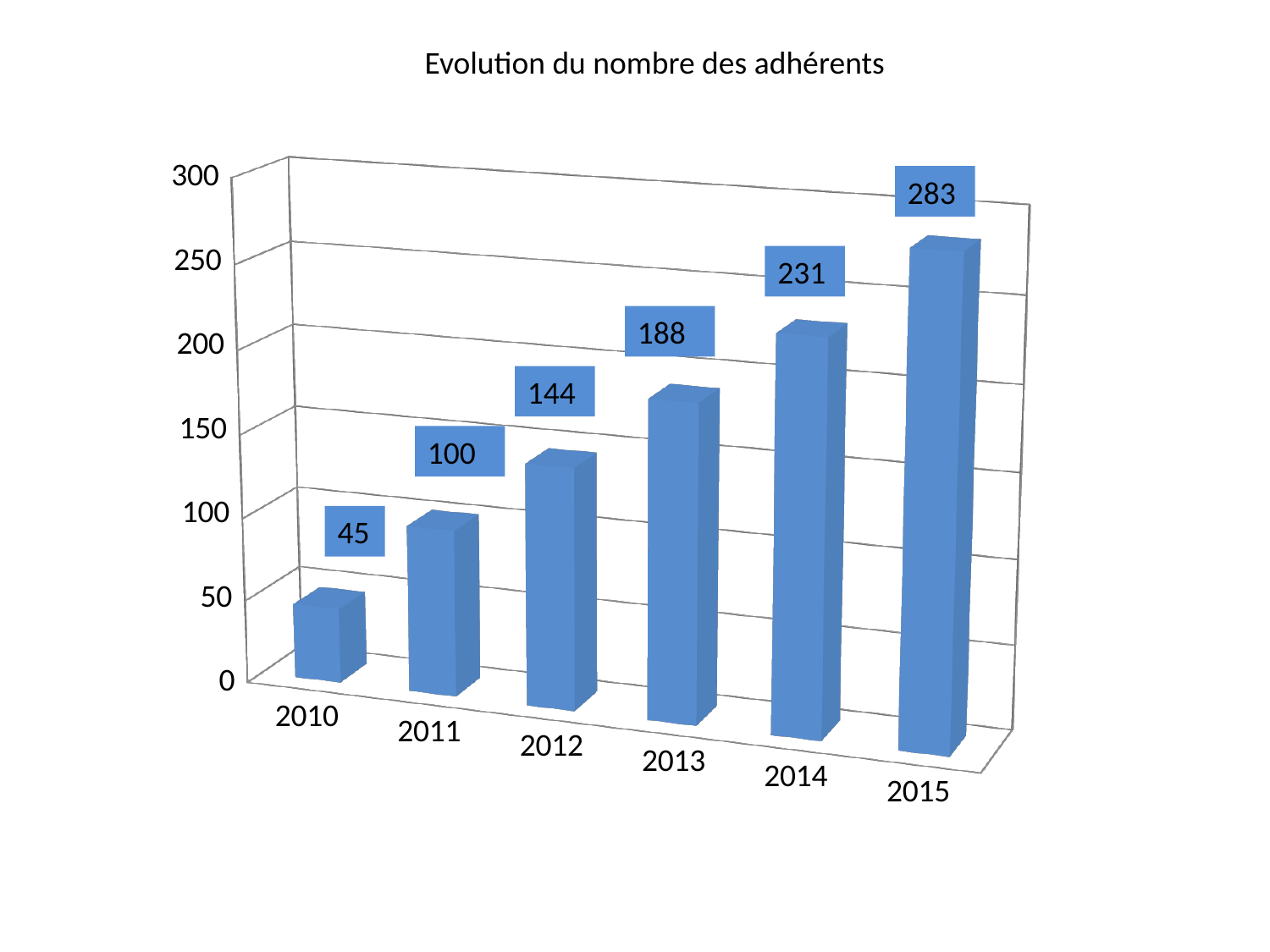
What is the value for 2015? 283 What kind of chart is this? bar chart Which year has the lowest value? 2010 Which year has the highest value? 2015 What is the value for 2010? 45 What is the title of the chart? Evolution du nombre des adhérents How many years are shown on the x axis? 6 What is the value for 2013? 188 Which is larger, the value for 2012 or the value for 2013? 2013 What is the difference between the values for 2015 and 2014? 52 What is the difference between the values for 2012 and 2011? 44 Do the values rise or fall from 2010 to 2015? rise